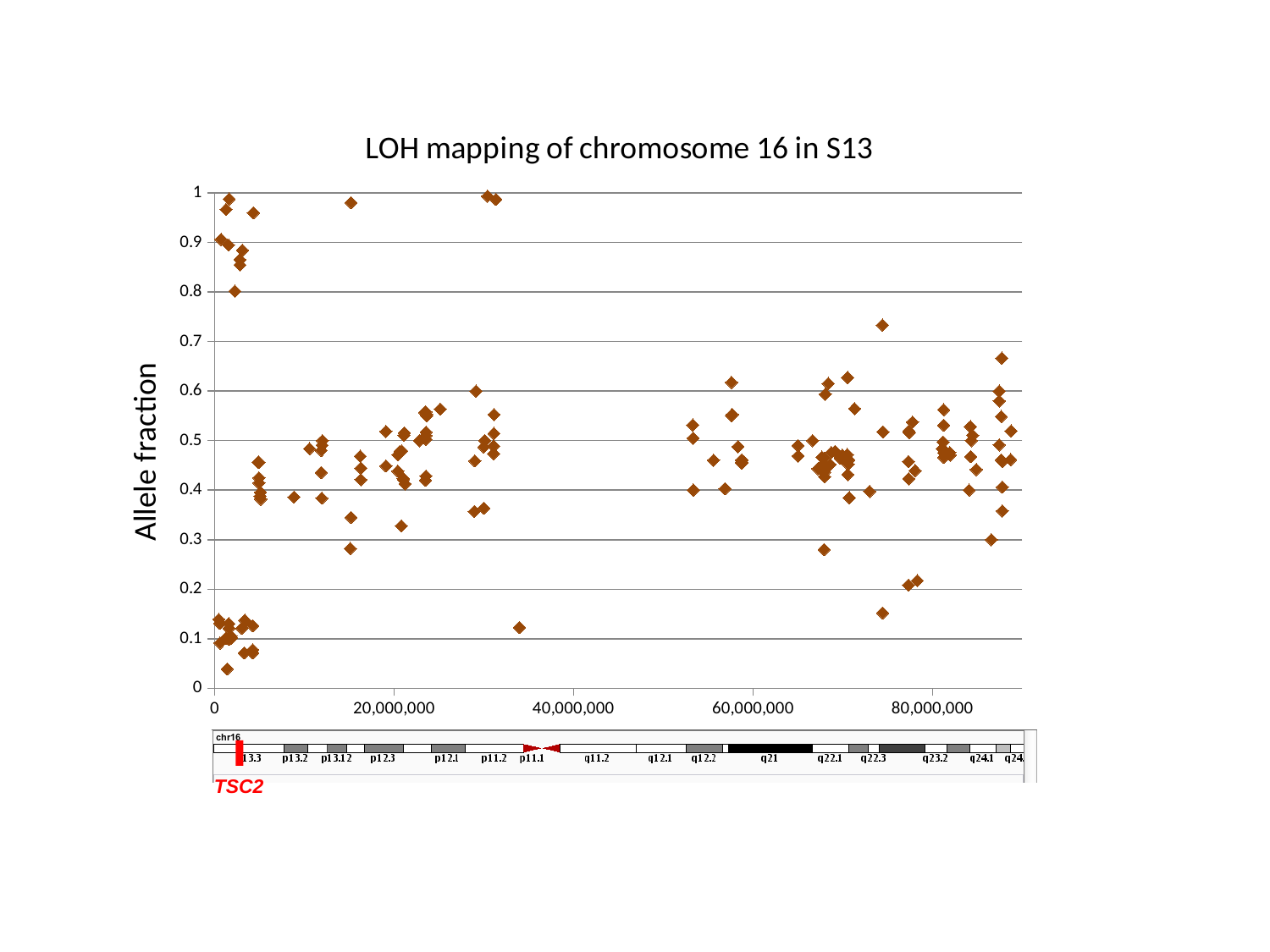
Is the highest point plotted between 60,000,000 and 80,000,000 greater or less than 0.7? greater What is the title of the chart? LOH mapping of chromosome 16 in S13 Is the lowest plotted allele fraction greater or less than 0.1? less Which gene is marked in red on the chromosome ideogram below the chart? TSC2 What is the label of the y axis? Allele fraction What kind of chart is shown on the slide? scatter plot Is the single point plotted near 34,000,000 on the x axis greater or less than 0.2? less What is the largest tick label shown on the x axis? 80,000,000 What is the highest tick value shown on the y axis? 1